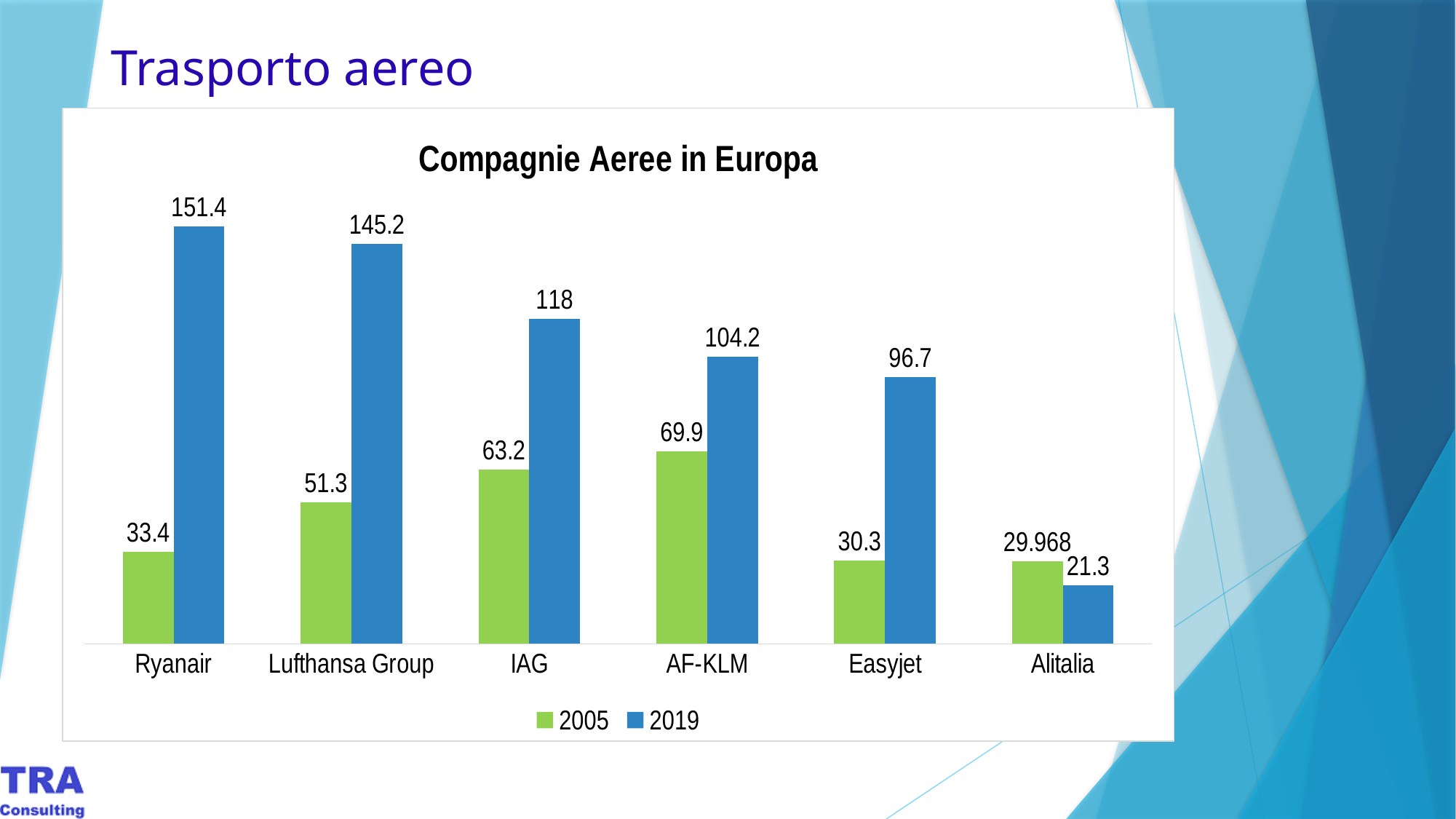
What is the 2019 value for Easyjet? 96.7 How many airlines are shown on the x axis? 6 What is the title of the chart? Compagnie Aeree in Europa Which airline has the highest 2005 value? AF-KLM How many series does the legend list? 2 Which is larger for Alitalia, the 2005 value or the 2019 value? 2005 What is the difference between the 2019 and 2005 values for IAG? 54.8 What is the 2005 value for Alitalia? 29.968 What is the 2019 value for Ryanair? 151.4 What kind of chart is shown? Bar chart Which airline has the highest 2019 value? Ryanair Which airline has the lowest 2019 value? Alitalia